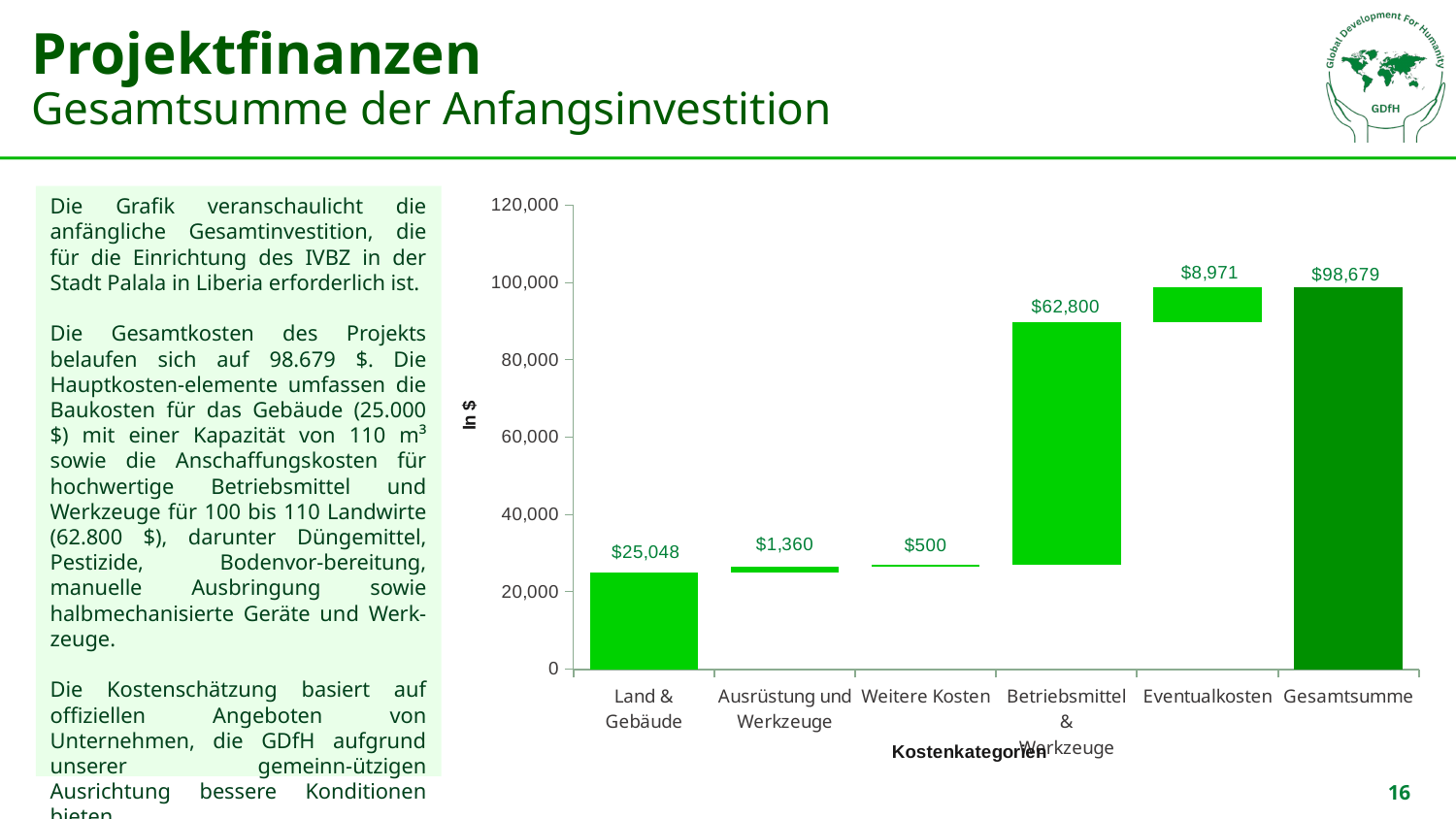
Excluding the Gesamtsumme total, which cost category has the highest value? Betriebsmittel & Werkzeuge What is the value shown for Gesamtsumme? $98,679 What is the value shown for Betriebsmittel & Werkzeuge? $62,800 What is the label of the y axis of the chart? In $ Which cost category has the lowest value? Weitere Kosten What is the value shown for Land & Gebäude? $25,048 How many categories are shown on the x axis of the chart? 6 Is the value for Gesamtsumme greater or less than 100,000? less Which is larger, the value for Ausrüstung und Werkzeuge or the value for Weitere Kosten? Ausrüstung und Werkzeuge What is the difference between the values for Land & Gebäude and Eventualkosten? $16,077 What is the value shown for Eventualkosten? $8,971 What is the value shown for Weitere Kosten? $500